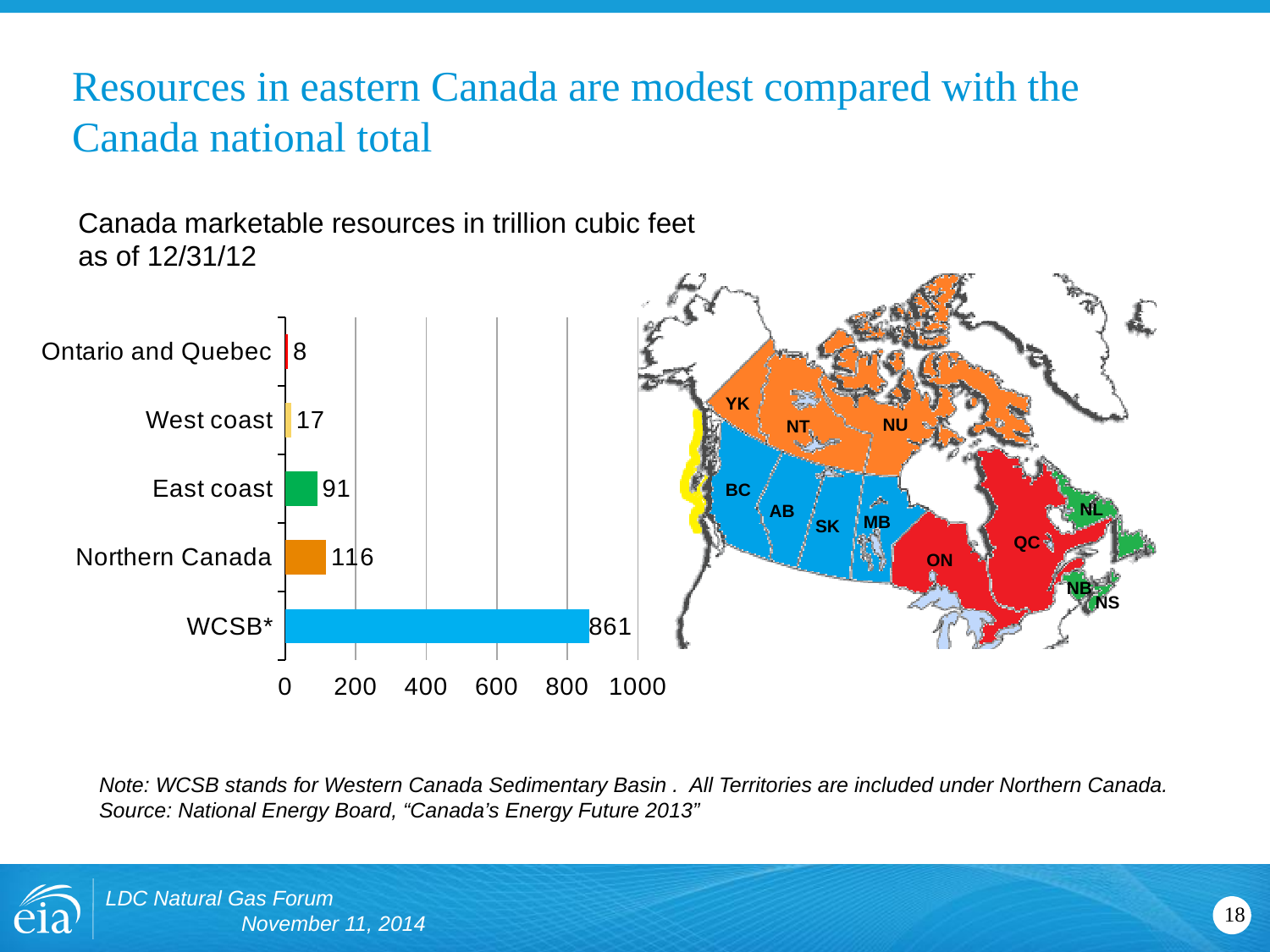
What is the value for West coast? 17 What is the value for Northern Canada? 116 How many categories are shown in the bar chart? 5 What is the value for WCSB* in the chart? 861 What is the difference between the values for WCSB* and Northern Canada? 745 Which category has the highest value? WCSB* Which is larger, the value for Northern Canada or the value for East coast? Northern Canada Which category has the lowest value? Ontario and Quebec What is the value for East coast? 91 What kind of chart is used to show Canada marketable resources? Bar chart What is the value for Ontario and Quebec? 8 What is the difference between the values for East coast and West coast? 74